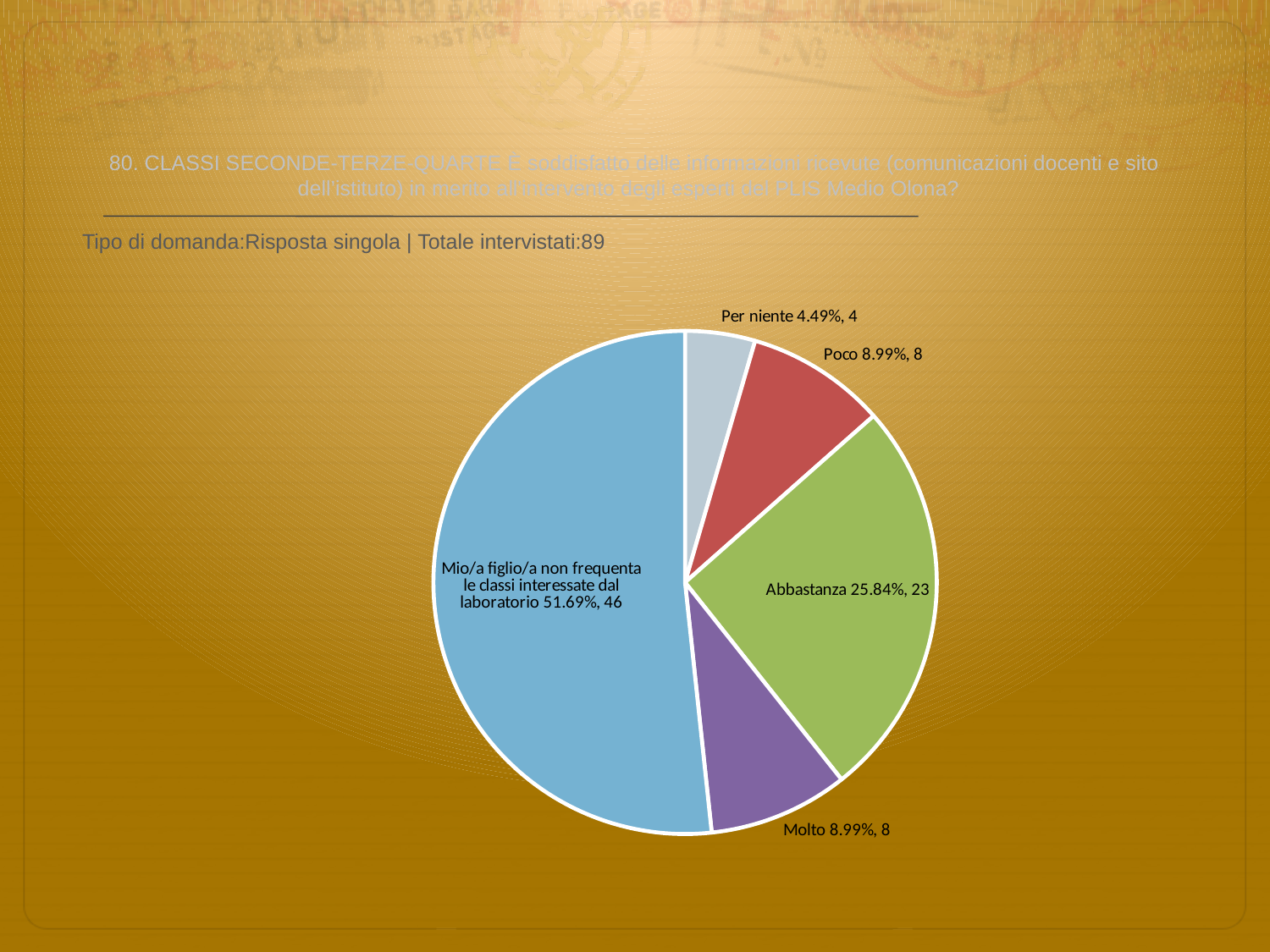
Which slice is the smallest in the pie chart? Per niente What colour is the 'Abbastanza' slice? green What percentage is shown for the 'Abbastanza' slice? 25.84% What percentage is shown for 'Molto'? 8.99% How many slices does the pie chart have? 5 Which has a larger count, 'Abbastanza' or 'Molto'? Abbastanza How many respondents chose 'Per niente'? 4 What count is shown for 'Mio/a figlio/a non frequenta le classi interessate dal laboratorio'? 46 What is the total number of respondents shown on the slide? 89 Which slice is the largest in the pie chart? Mio/a figlio/a non frequenta le classi interessate dal laboratorio What kind of chart is shown on the slide? pie chart What is the difference in count between 'Abbastanza' and 'Poco'? 15